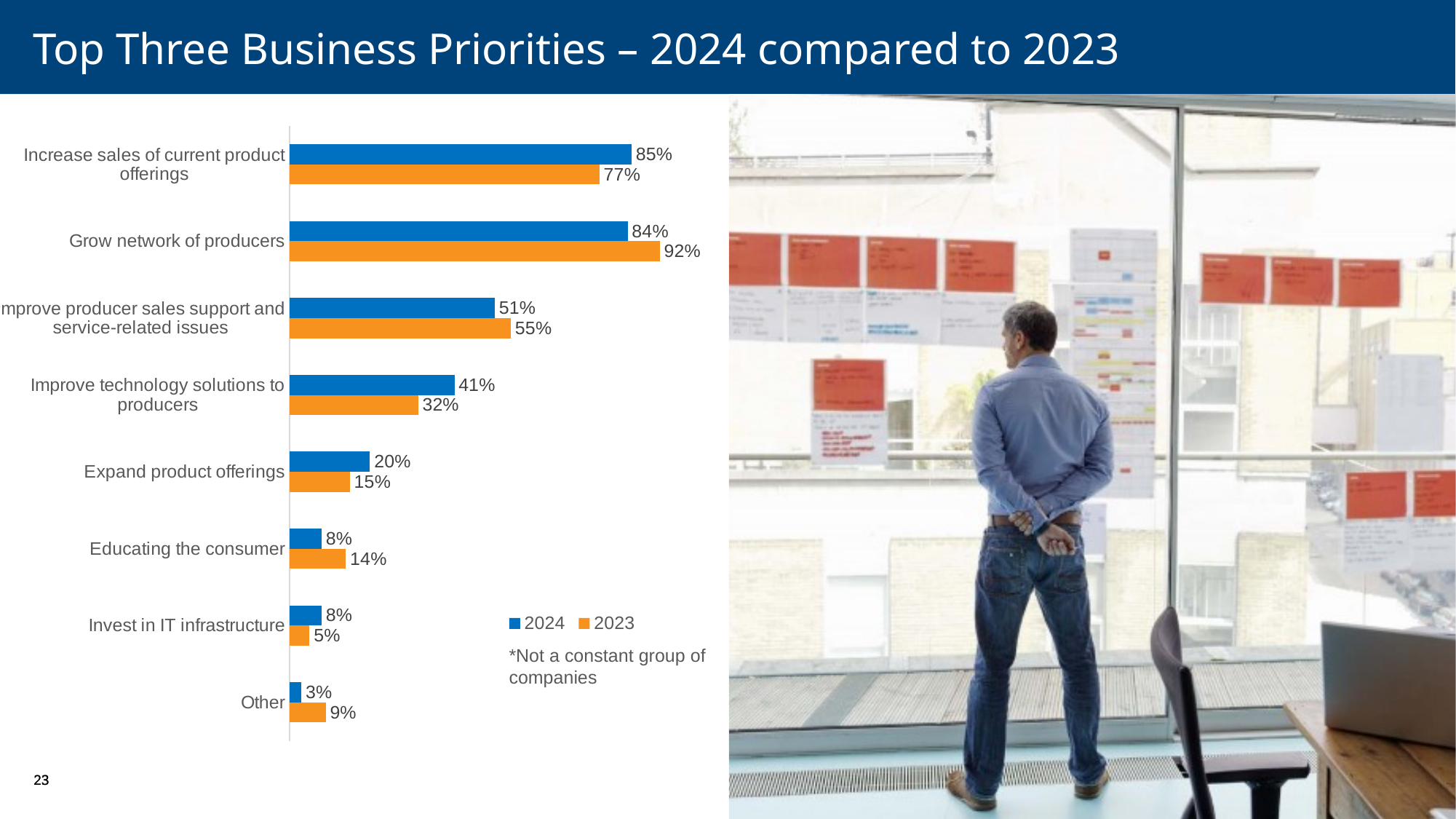
Which category has the lowest 2023 value? Invest in IT infrastructure Which is larger for Expand product offerings, the 2024 value or the 2023 value? 2024 What is the difference between the 2024 and 2023 values for Grow network of producers? 8% What is the 2024 value for Increase sales of current product offerings? 85% What is the 2023 value for Grow network of producers? 92% What is the 2023 value for Educating the consumer? 14% What is the 2024 value for Improve technology solutions to producers? 41% What is the difference between the 2024 and 2023 values for Improve technology solutions to producers? 9% How many categories are shown in the chart? 8 What kind of chart is shown on the slide? Bar chart How many series does the legend list? 2 Which category has the highest 2024 value? Increase sales of current product offerings